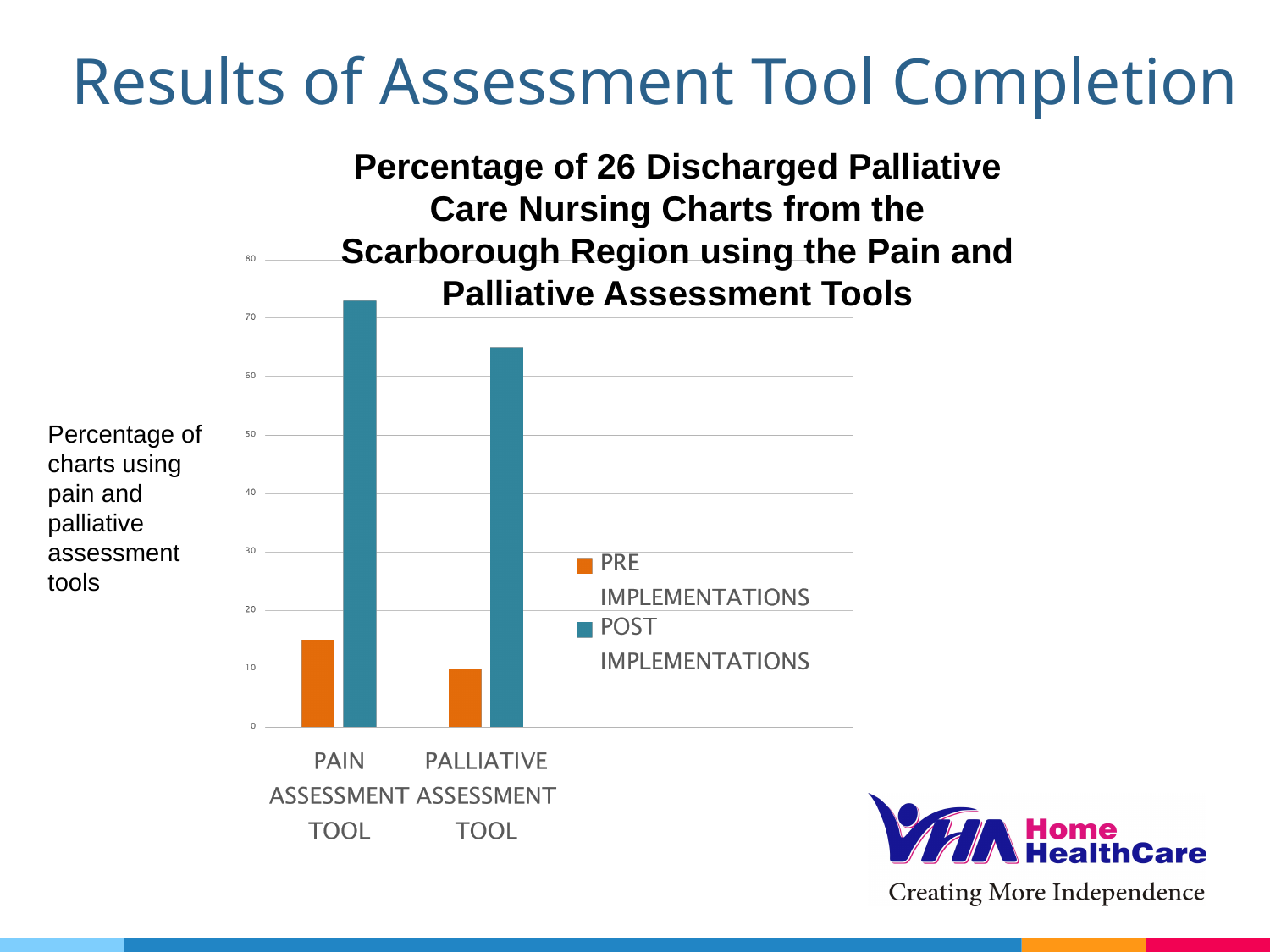
Is the PRE IMPLEMENTATIONS value for PALLIATIVE ASSESSMENT TOOL greater or less than 20? less Which series does the orange bar represent in the chart? PRE IMPLEMENTATIONS What kind of chart is shown on the slide? bar chart Which series does the teal bar represent in the chart? POST IMPLEMENTATIONS How many series does the chart's legend list? 2 Is the PRE IMPLEMENTATIONS value for PAIN ASSESSMENT TOOL greater or less than 20? less Is the POST IMPLEMENTATIONS value for PAIN ASSESSMENT TOOL greater or less than 60? greater Which bar in the chart is the tallest overall? POST IMPLEMENTATIONS for PAIN ASSESSMENT TOOL Which bar in the chart is the shortest overall? PRE IMPLEMENTATIONS for PALLIATIVE ASSESSMENT TOOL Which category has the higher POST IMPLEMENTATIONS value, PAIN ASSESSMENT TOOL or PALLIATIVE ASSESSMENT TOOL? PAIN ASSESSMENT TOOL How many categories are shown on the x axis of the chart? 2